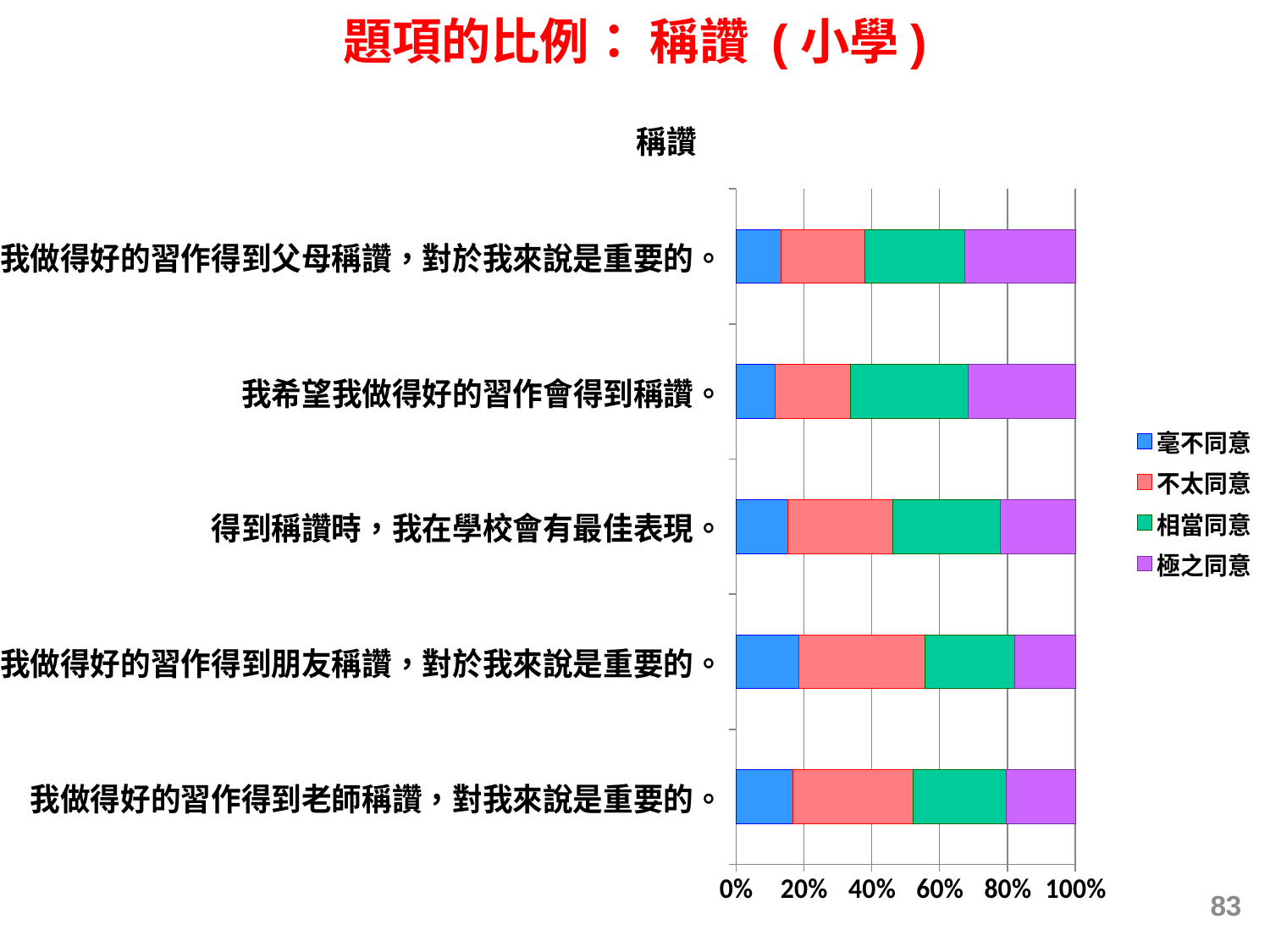
Is the 極之同意 share for 「我做得好的習作得到父母稱讚，對於我來說是重要的。」 greater or less than 20%? greater What is the total of each stacked bar in the chart? 100% Is the 不太同意 share for 「我做得好的習作得到朋友稱讚，對於我來說是重要的。」 greater or less than 20%? greater Which legend entry is shown in purple? 極之同意 How many series does the legend list? 4 Is the 極之同意 share for 「我做得好的習作得到老師稱讚，對我來說是重要的。」 greater or less than 40%? less Which statement has the larger 不太同意 share: 「我希望我做得好的習作會得到稱讚。」 or 「我做得好的習作得到朋友稱讚，對於我來說是重要的。」? 我做得好的習作得到朋友稱讚，對於我來說是重要的。 How many statements (categories) are plotted in the chart? 5 Which statement has the larger 極之同意 share: 「我做得好的習作得到父母稱讚，對於我來說是重要的。」 or 「我做得好的習作得到朋友稱讚，對於我來說是重要的。」? 我做得好的習作得到父母稱讚，對於我來說是重要的。 What is the title of the chart? 稱讚 What kind of chart is shown on the slide? bar chart